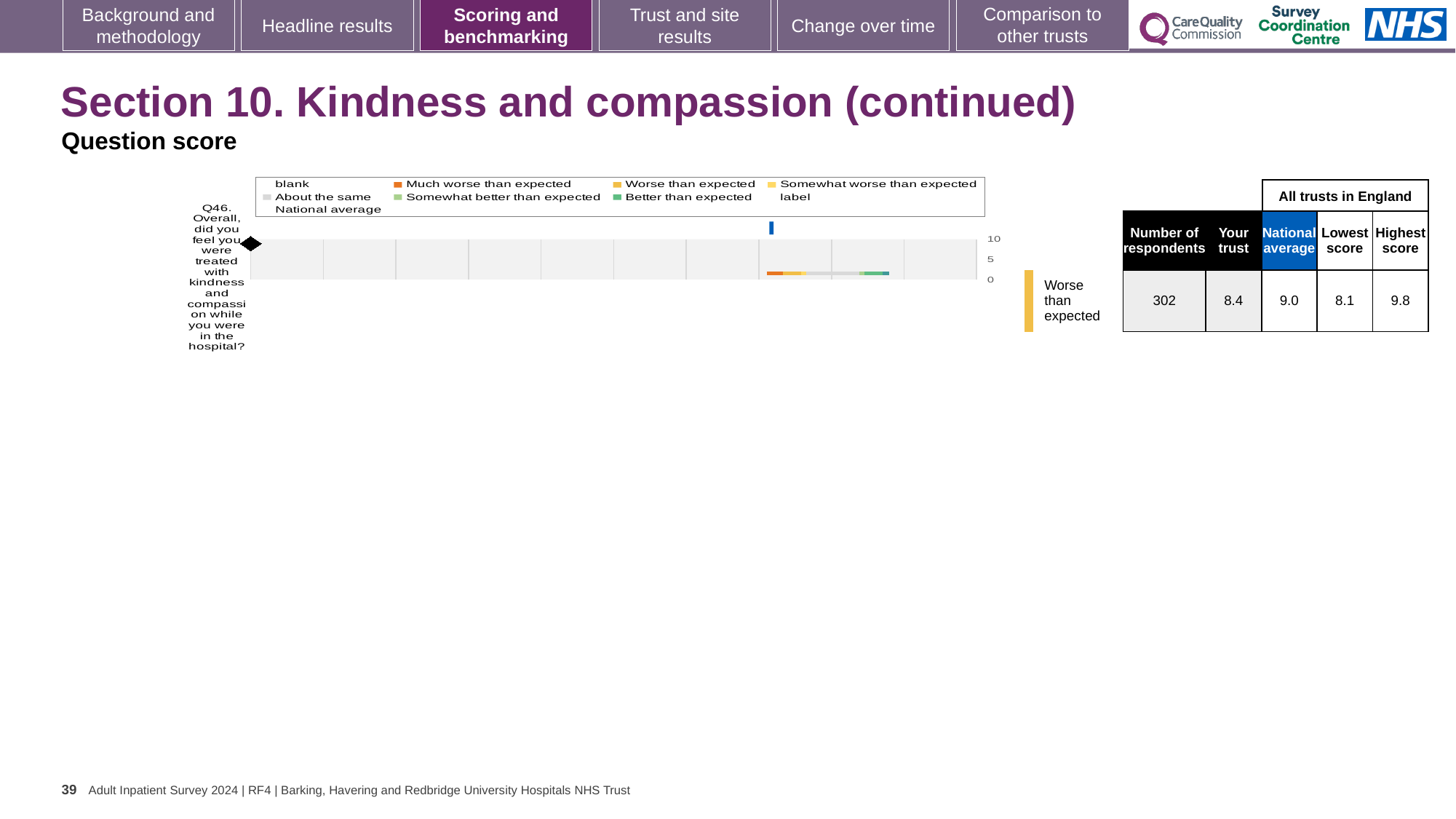
What is the highest score among all trusts in England for Q46? 9.8 What is the difference between the highest and lowest scores among all trusts in England for Q46? 1.7 What kind of chart is used to show the Q46 question score? Bar chart Which is larger for Q46, the 'Your trust' score or the national average? National average What is the difference between the national average and the 'Your trust' score for Q46? 0.6 Is the 'Your trust' score for Q46 greater or less than 5? greater What benchmark rating is shown next to the chart for Q46? Worse than expected Which question number is plotted on the chart? Q46 What is the lowest score among all trusts in England for Q46? 8.1 What is the score for 'Your trust' shown for Q46? 8.4 What is the national average score shown for Q46? 9.0 How many respondents are shown for Q46? 302